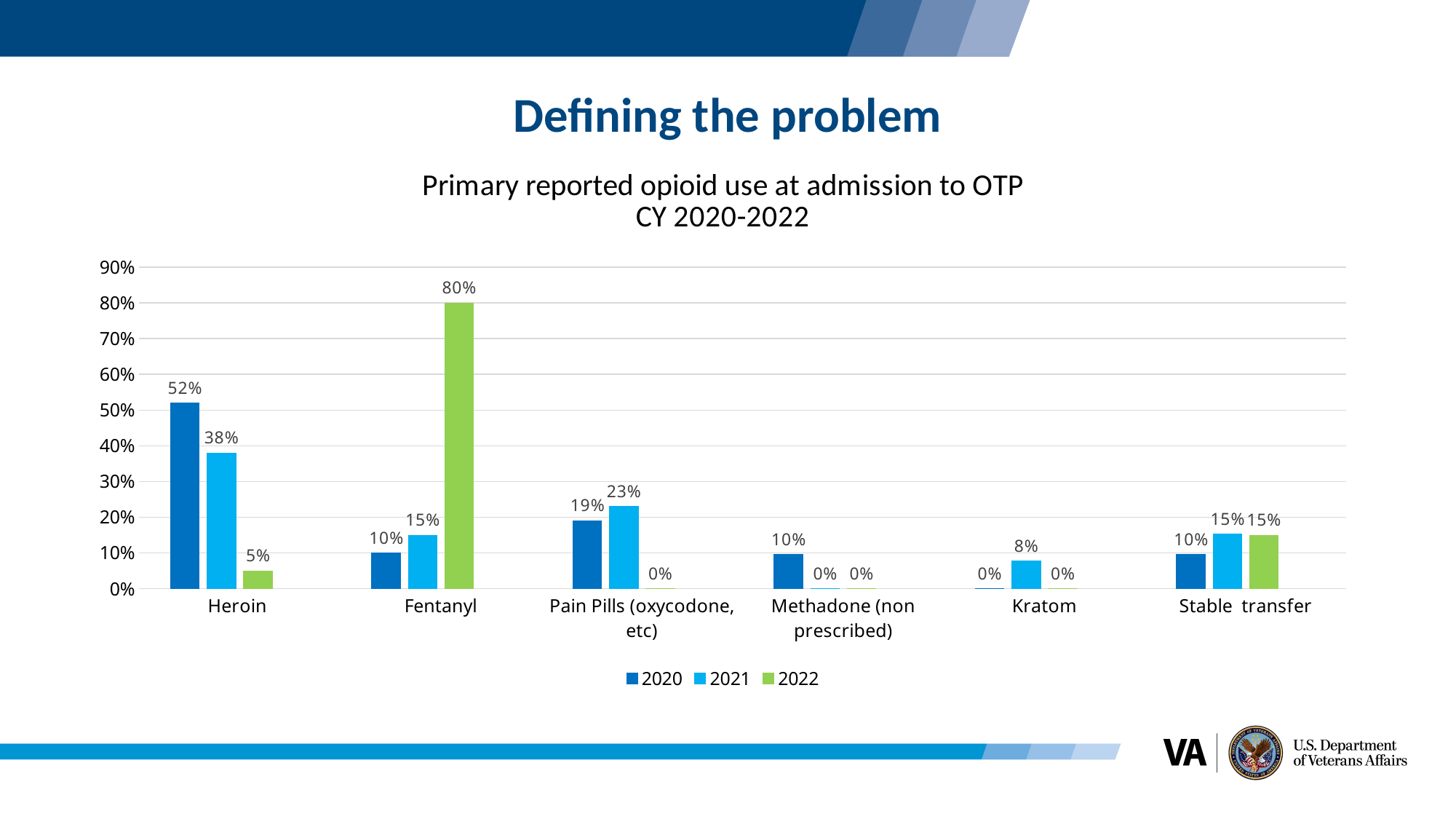
What is the title of the chart? Primary reported opioid use at admission to OTP CY 2020-2022 What is the value for Fentanyl in 2022? 80% Which category has the highest value in the 2020 series? Heroin How many categories are shown on the x axis? 6 How many series does the legend list? 3 What is the difference between the Heroin values for 2020 and 2021? 14% What is the value for Kratom in 2021? 8% Which is larger: the 2021 value for Heroin or the 2021 value for Pain Pills (oxycodone, etc)? Heroin What is the value for Heroin in 2020? 52% Which category has the highest value in the 2022 series? Fentanyl What is the value for Pain Pills (oxycodone, etc) in 2021? 23% What kind of chart is shown on the slide? Bar chart